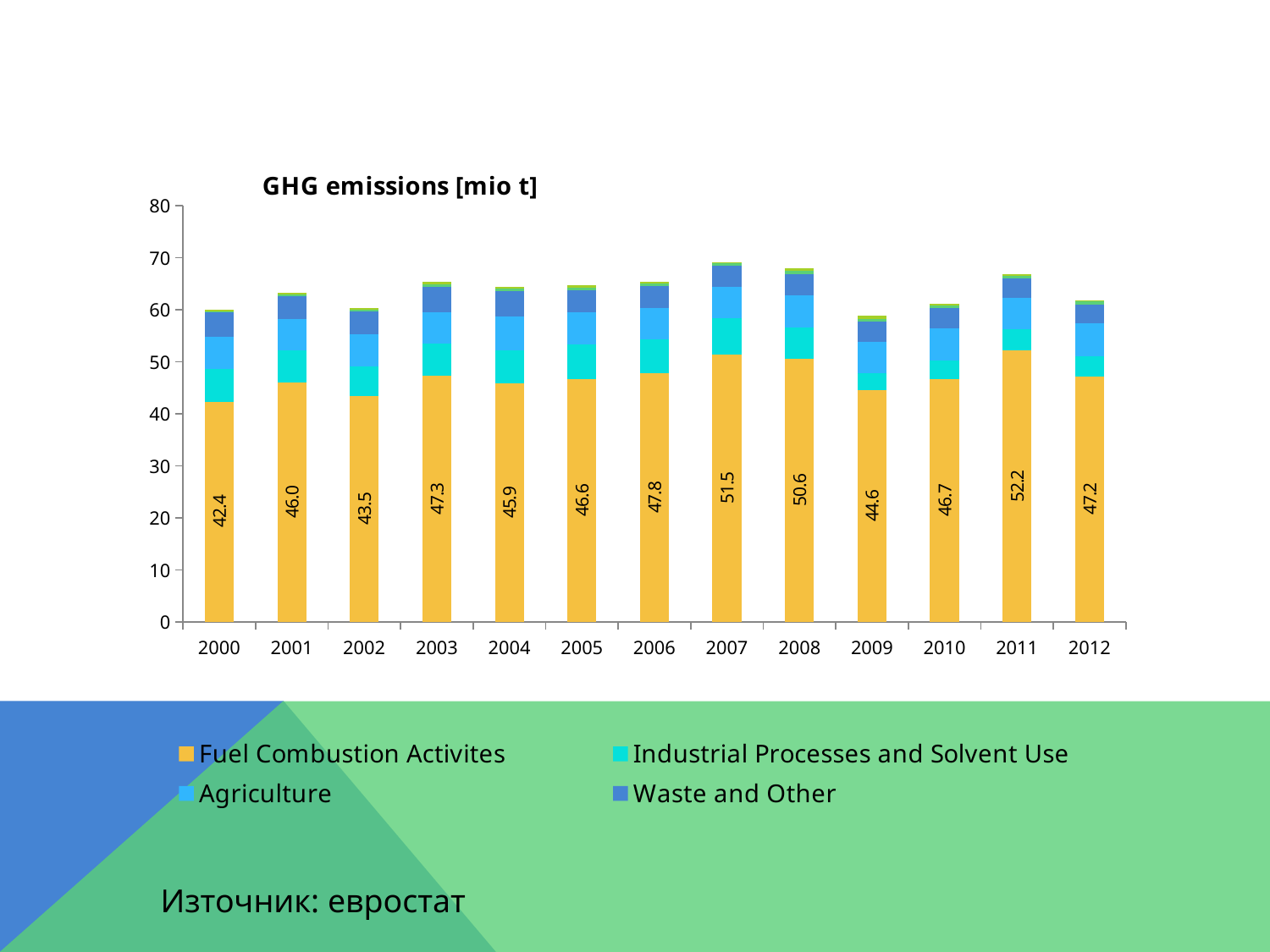
What is the value for Fuel Combustion Activites in 2012? 47.2 How many years are shown on the x axis? 13 Which year has the larger Fuel Combustion Activites value, 2003 or 2004? 2003 In which year is the Fuel Combustion Activites value lowest? 2000 What is the title of the chart? GHG emissions [mio t] Is the total stacked value for 2007 greater or less than 60? greater How many series does the legend list? 4 What is the difference between the Fuel Combustion Activites values for 2011 and 2000? 9.8 In which year is the Fuel Combustion Activites value highest? 2011 What kind of chart is shown on the slide? Stacked bar chart What is the value for Fuel Combustion Activites in 2007? 51.5 What is the value for Fuel Combustion Activites in 2000? 42.4